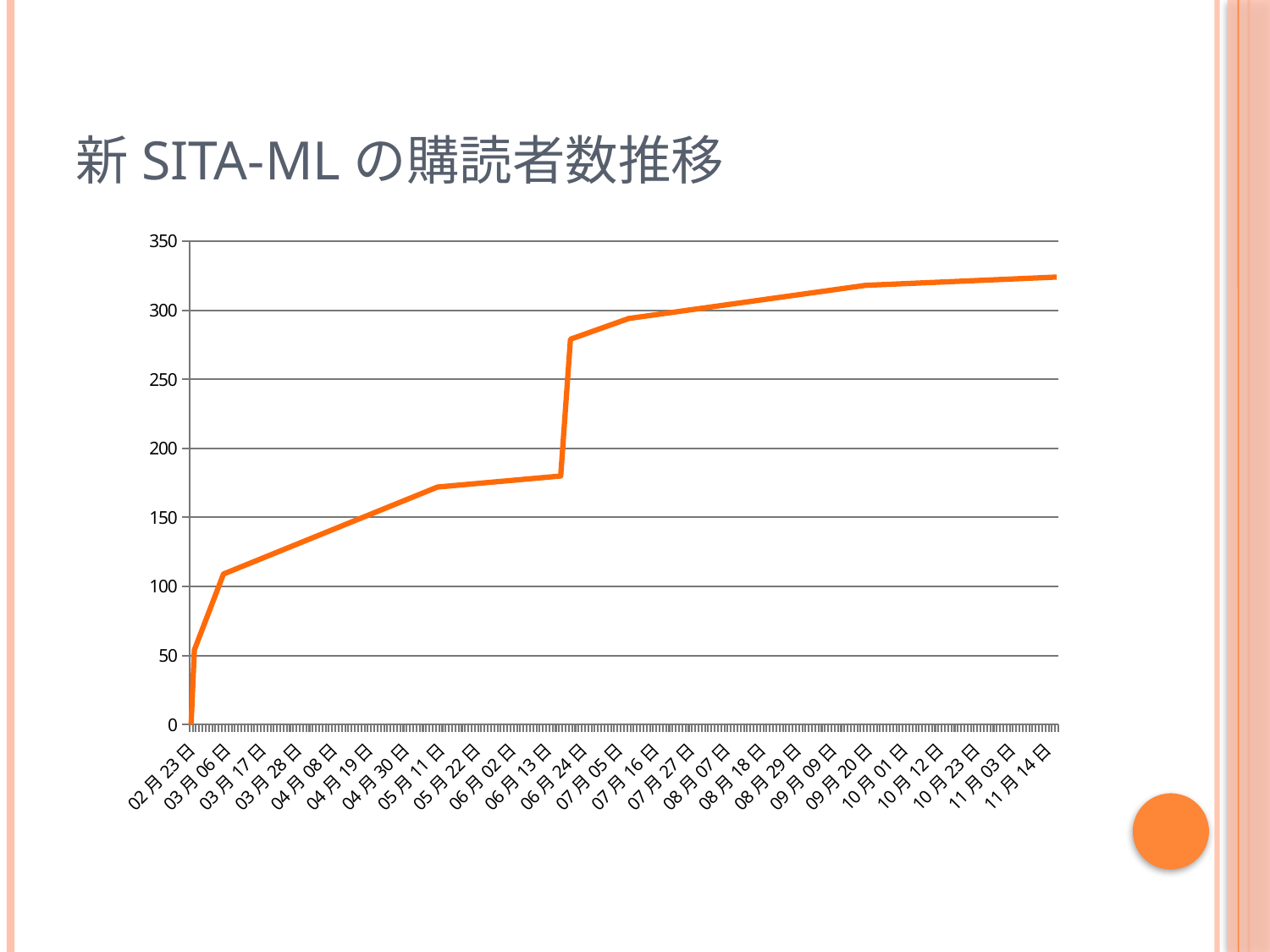
Is the value for 03月06日 greater or less than 100? greater Is the value for 11月14日 greater or less than 300? greater Is the value for 07月05日 greater or less than 250? greater Which is larger, the value for 06月24日 or the value for 06月13日? 06月24日 Do the values rise or fall along the x axis from 02月23日 to 11月14日? rise What kind of chart is shown on the slide? line chart Which date has the highest value on the chart? 11月14日 What is the title of the chart? 新 SITA-ML の購読者数推移 What is the maximum value shown on the y axis? 350